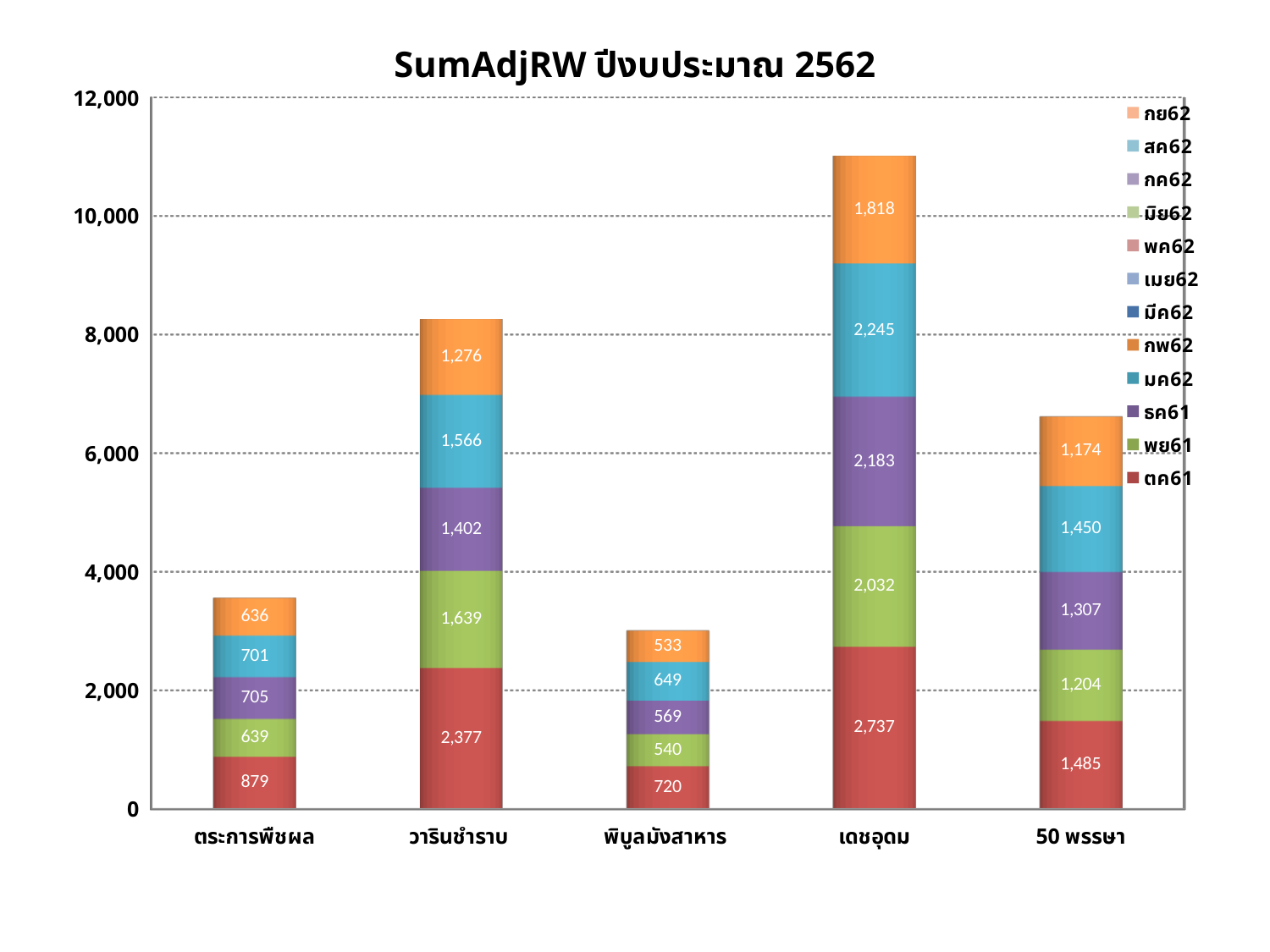
What is the value of the ตค61 segment for เดชอุดม? 2,737 Is the total stacked bar for 50 พรรษา greater or less than 6,000? greater What is the title of the chart? SumAdjRW ปีงบประมาณ 2562 What is the total of the stacked bar for ตระการพืชผล? 3,560 How many categories are shown on the x axis? 5 Which category has the tallest stacked bar? เดชอุดม How many series does the legend list? 12 Which category has the shortest stacked bar? พิบูลมังสาหาร What is the difference between the ตค61 values for วารินชำราบ and 50 พรรษา? 892 What is the value of the พย61 segment for 50 พรรษา? 1,204 What is the value of the กพ62 segment for วารินชำราบ? 1,276 What kind of chart is shown on the slide? Stacked bar chart